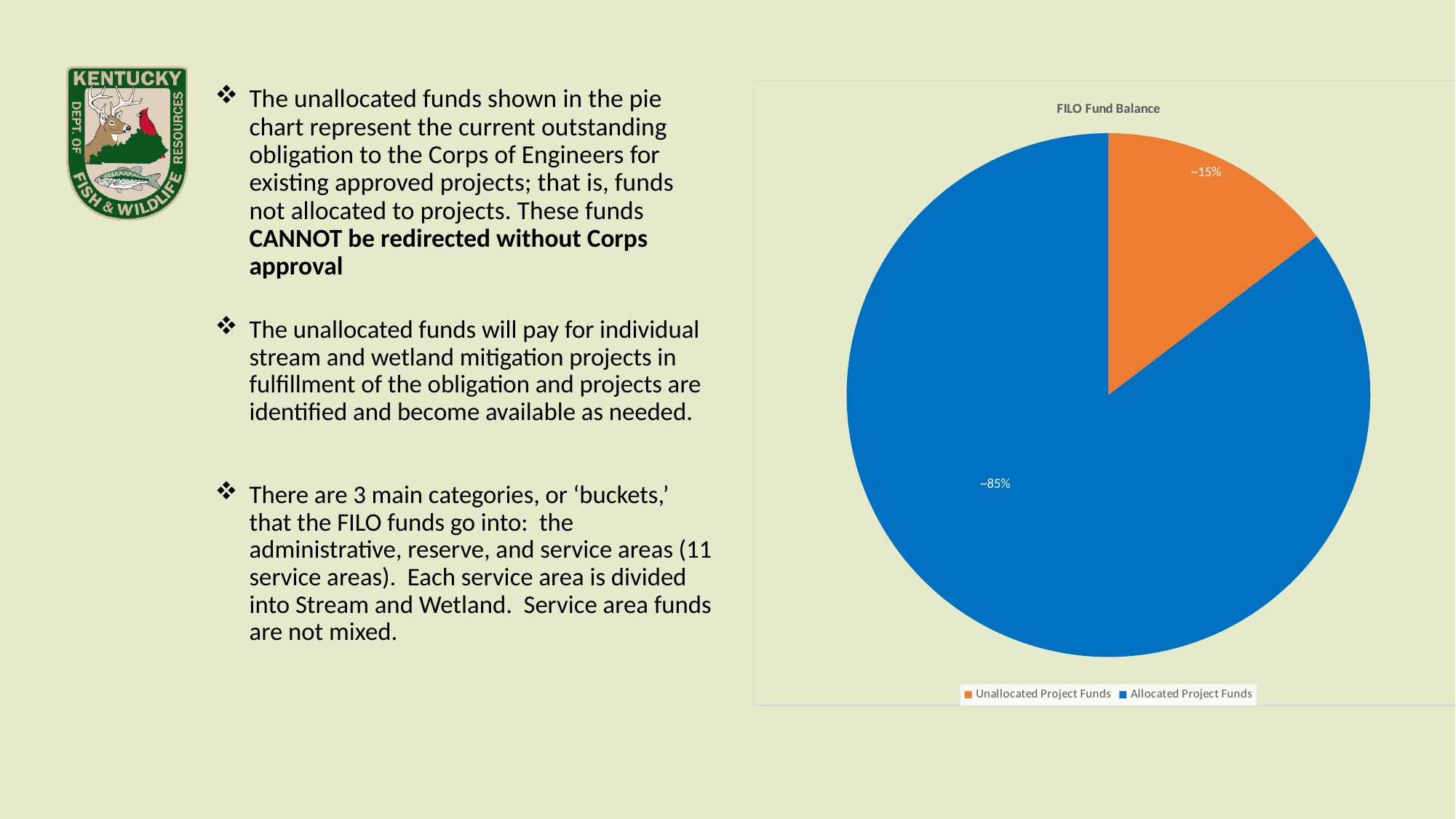
Which slice is the smallest in the pie chart? Unallocated Project Funds What is the title of the chart? FILO Fund Balance What kind of chart is shown on the slide? pie chart Which is larger, Unallocated Project Funds or Allocated Project Funds? Allocated Project Funds How many entries does the legend list? 2 What label is printed on the Unallocated Project Funds slice? ~15% Which slice is the largest in the pie chart? Allocated Project Funds What label is printed on the Allocated Project Funds slice? ~85% What colour is the Unallocated Project Funds slice? orange How many slices does the pie chart have? 2